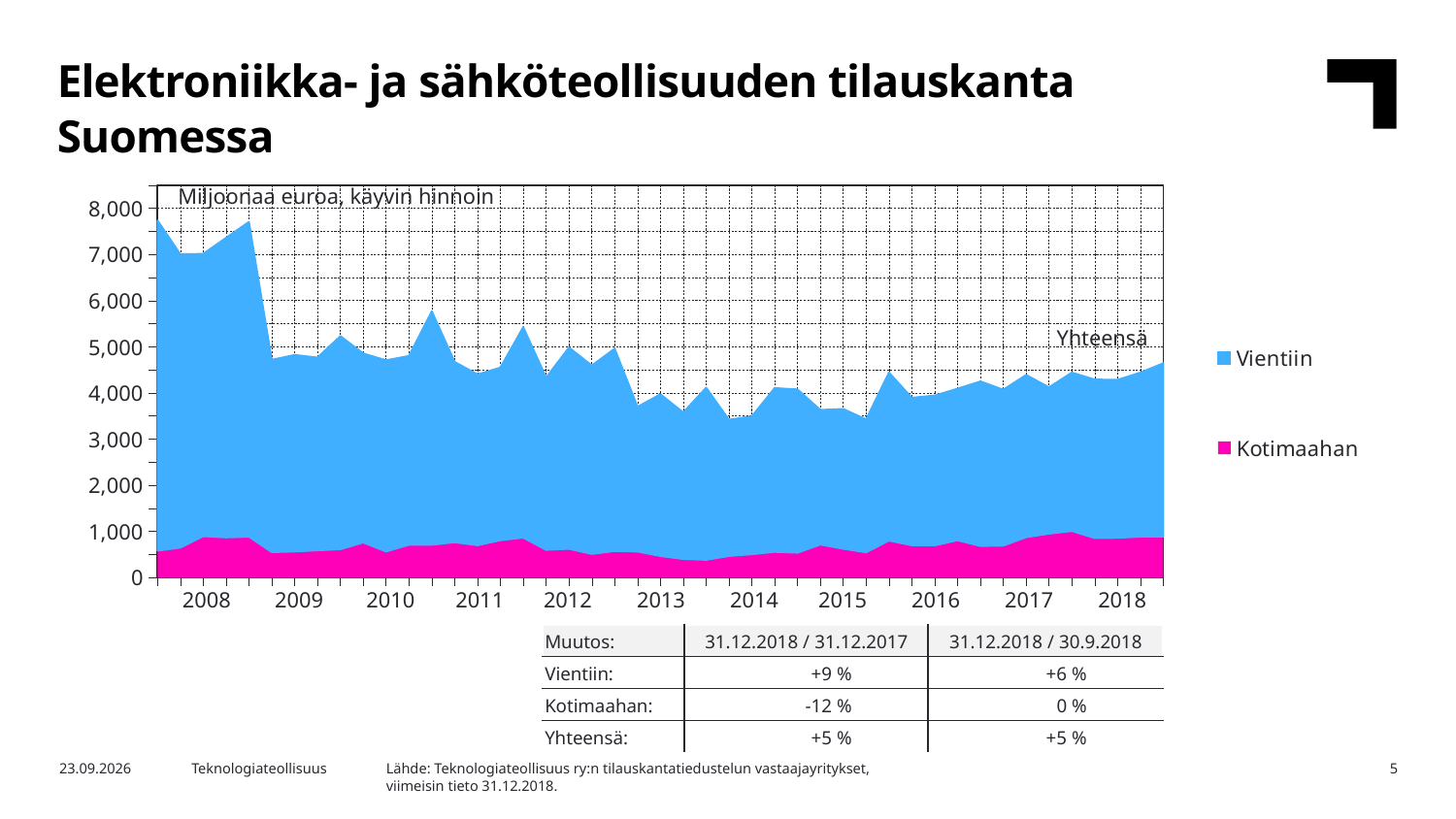
How many series does the chart legend list? 2 What are the two series named in the chart legend? Vientiin and Kotimaahan Is the total order backlog (Yhteensä) in 2010 greater or less than 4,000? greater Is the total order backlog (Yhteensä) at the start of 2008 greater or less than 7,000? greater Is the total order backlog (Yhteensä) in 2016 greater or less than 5,000? less What kind of chart is shown on the slide? Area chart Which series is larger throughout the chart, Vientiin or Kotimaahan? Vientiin Overall, does the total order backlog rise or fall from 2008 to 2018? Fall What unit is stated in the label at the top of the chart? Miljoonaa euroa, käyvin hinnoin Does the total order backlog rise or fall between 2008 and 2009? Fall How many years are labelled on the x axis of the chart? 11